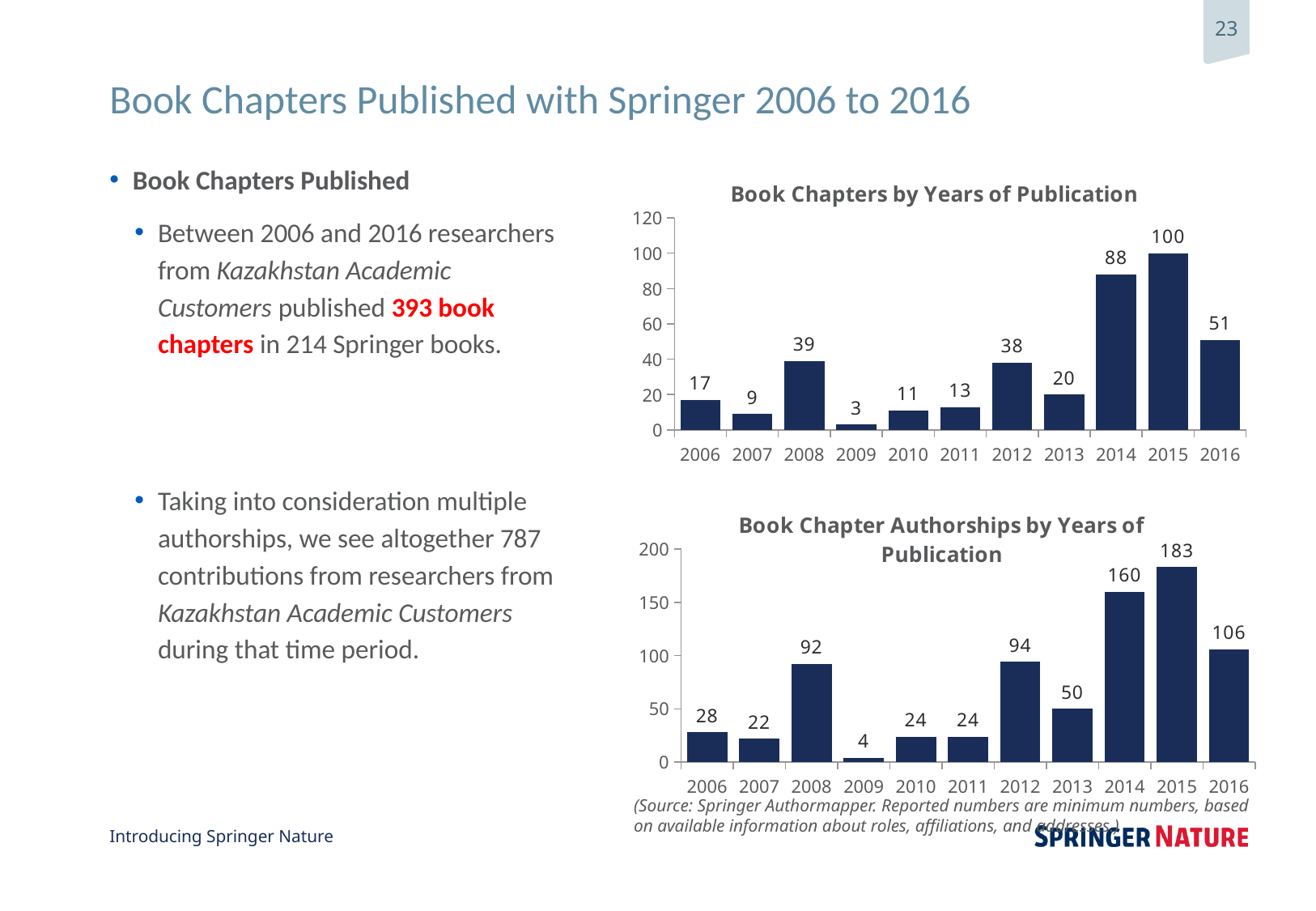
In the 'Book Chapters by Years of Publication' chart, which year has the highest value? 2015 In the 'Book Chapter Authorships by Years of Publication' chart, do the values rise or fall from 2013 to 2015? Rise In the 'Book Chapters by Years of Publication' chart, which year has the lowest value? 2009 In the 'Book Chapter Authorships by Years of Publication' chart, what is the difference between the values for 2014 and 2015? 23 In the 'Book Chapter Authorships by Years of Publication' chart, which is larger, the value for 2008 or the value for 2013? 2008 In the 'Book Chapters by Years of Publication' chart, how many years are shown on the x axis? 11 In the 'Book Chapter Authorships by Years of Publication' chart, which year has the highest value? 2015 In the 'Book Chapter Authorships by Years of Publication' chart, which year has the lowest value? 2009 In the 'Book Chapters by Years of Publication' chart, what is the value for 2014? 88 In the 'Book Chapter Authorships by Years of Publication' chart, what is the value for 2012? 94 In the 'Book Chapters by Years of Publication' chart, what is the difference between the values for 2015 and 2016? 49 What kind of chart is 'Book Chapters by Years of Publication'? Bar chart